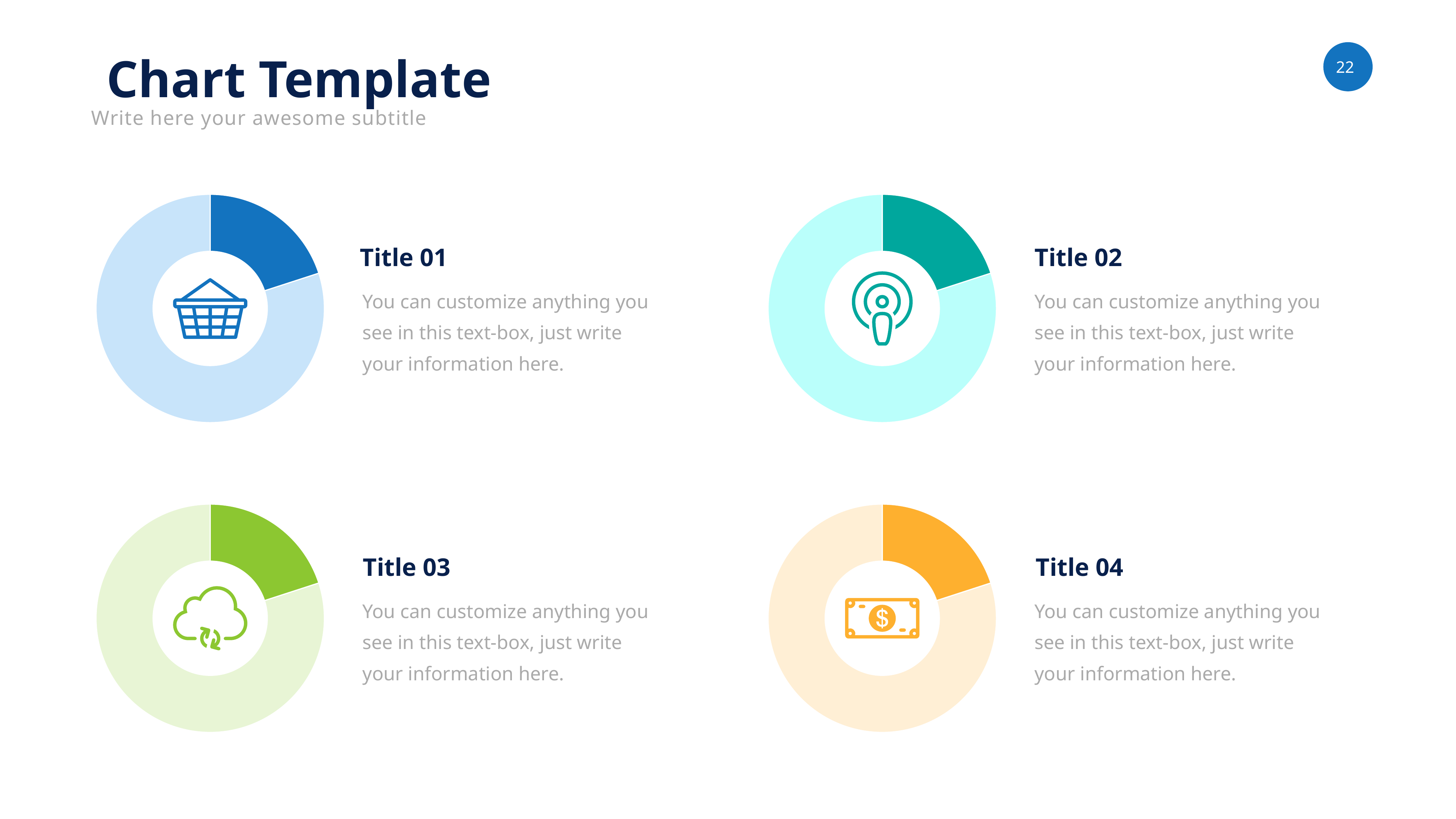
What kind of chart is shown next to Title 01? donut chart In the donut chart next to Title 04, which slice is the smallest? the dark orange slice In the donut chart next to Title 02, which slice is the largest? the light teal slice How many donut charts are on the slide? 4 What colour is the highlighted (darker) slice in the donut chart next to Title 04? orange In the donut chart next to Title 01, is the dark blue slice larger or smaller than the light blue slice? smaller What colour is the highlighted (darker) slice in the donut chart next to Title 03? green How many slices does the donut chart next to Title 03 have? 2 What kind of chart is shown next to Title 04? donut chart In the donut chart next to Title 03, is the dark green slice larger or smaller than the light green slice? smaller How many slices does the donut chart next to Title 01 have? 2